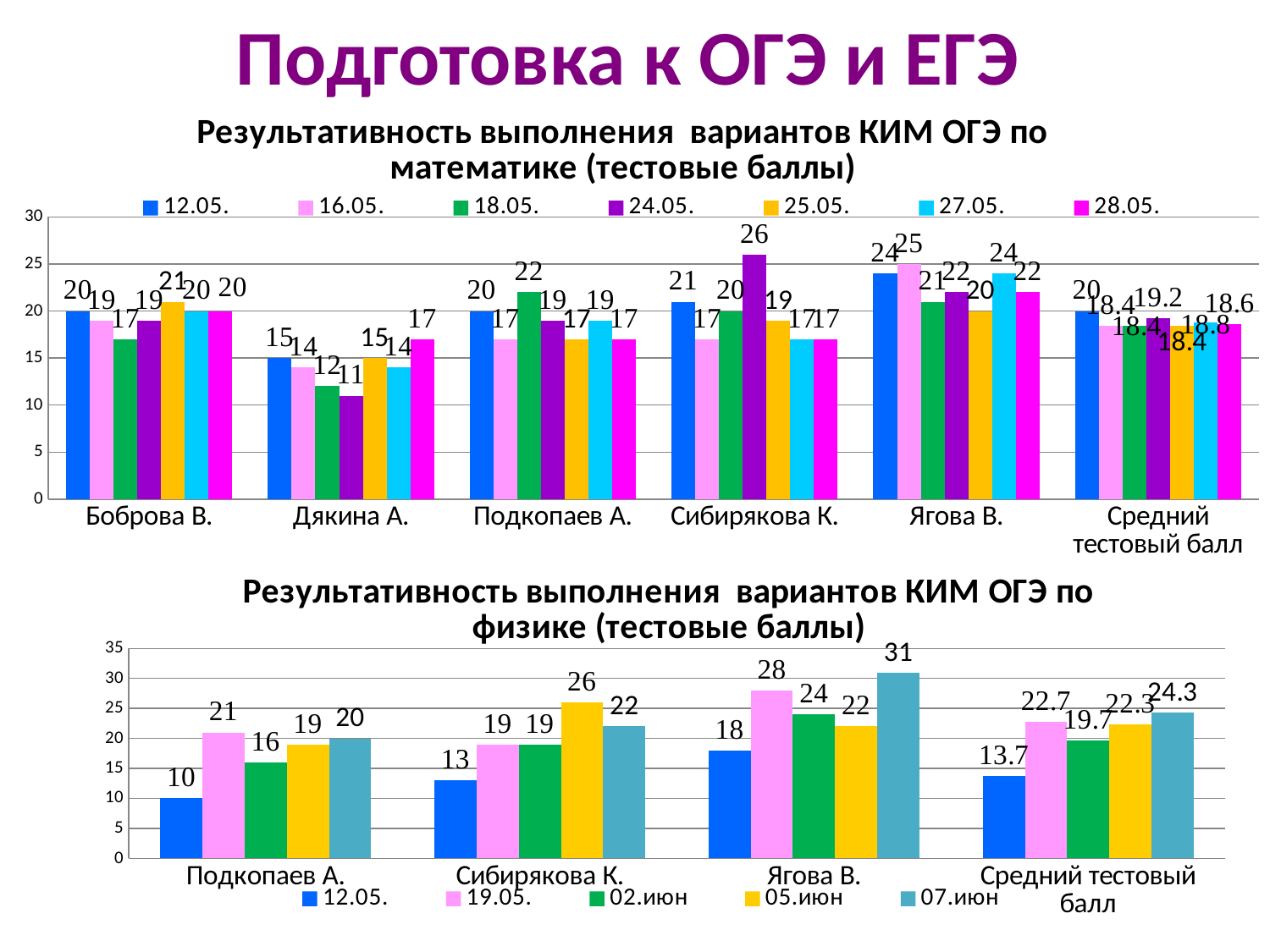
In the top chart (mathematics), how many series does the legend list? 7 In the bottom chart (physics), which date has the highest value for Подкопаев А.? 19.05. In the top chart (mathematics), what is the Средний тестовый балл for 24.05.? 19.2 What type of chart is the bottom chart (physics)? Bar chart In the top chart (mathematics), what is the difference between the 24.05. and 16.05. values for Сибирякова К.? 9 In the top chart (mathematics), what is the value for Сибирякова К. on 24.05.? 26 In the bottom chart (physics), which is larger for Сибирякова К.: the 05.июн value or the 07.июн value? 05.июн In the bottom chart (physics), how many categories are shown on the x axis? 4 In the bottom chart (physics), what is the Средний тестовый балл for 12.05.? 13.7 In the top chart (mathematics), which date has the lowest value for Дякина А.? 24.05. In the bottom chart (physics), what is the value for Ягова В. on 07.июн? 31 In the top chart (mathematics), what is the value for Дякина А. on 28.05.? 17